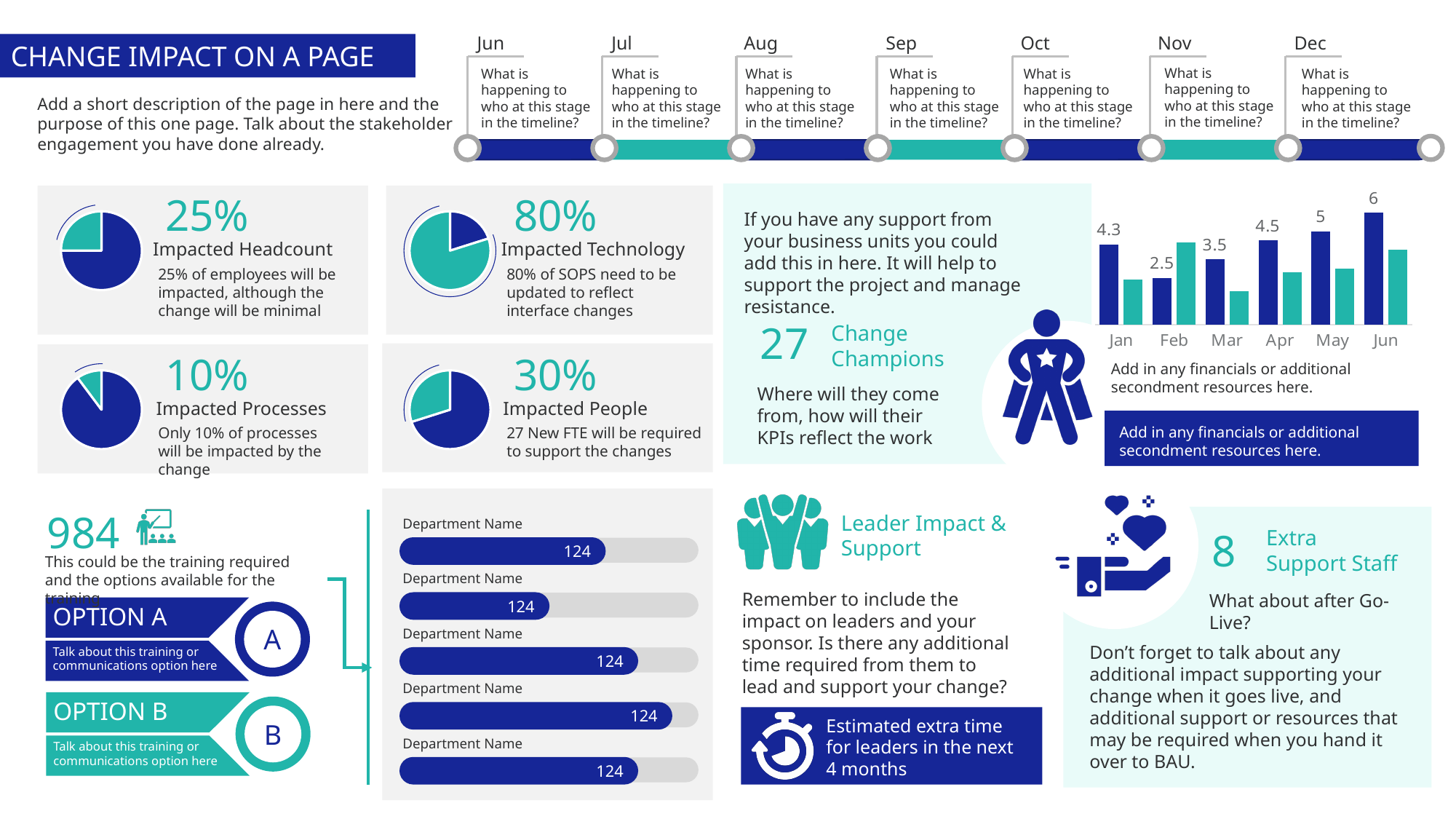
In the bar chart at the top right, what is the difference between the labelled values for Jun and Jan? 1.7 In the bar chart at the top right, what is the labelled value for Feb? 2.5 In the bar chart at the top right, which has the larger labelled value, Mar or Apr? Apr What percentage is shown in the Impacted Technology pie chart? 80% In the bar chart at the top right, do the labelled values rise or fall from Feb to Jun? Rise In the bar chart at the top right, which month has the highest labelled value? Jun Of the four pie charts on the left (Impacted Headcount, Impacted Technology, Impacted Processes, Impacted People), which shows the lowest percentage? Impacted Processes What kind of chart is shown at the top right of the slide, next to the superhero icon? Bar chart How many months are shown on the x axis of the bar chart at the top right? 6 How many Department Name bars are shown in the horizontal bar chart at the bottom centre of the slide? 5 In the bar chart at the top right, which month has the lowest labelled value? Feb In the bar chart at the top right, what is the labelled value for Jun? 6